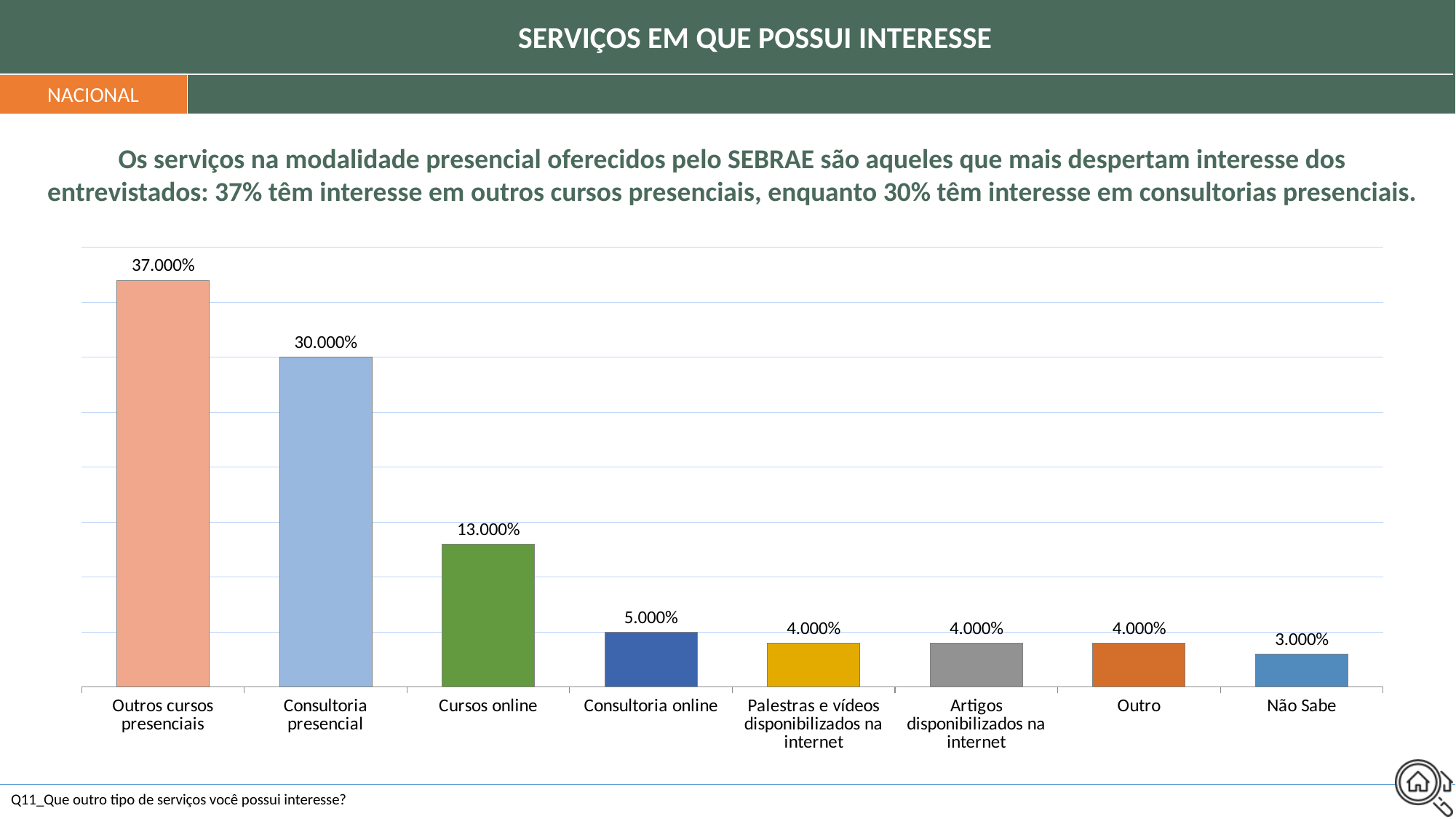
What is the value for Outros cursos presenciais? 37.000% What is the value for Cursos online? 13.000% What is the title of the slide? SERVIÇOS EM QUE POSSUI INTERESSE Which category has the lowest value? Não Sabe What is the value for Não Sabe? 3.000% Which is larger, Cursos online or Consultoria online? Cursos online Which category has the highest value? Outros cursos presenciais What is the difference between Outros cursos presenciais and Consultoria presencial? 7.000% How many categories are shown on the x axis? 8 What is the value for Consultoria presencial? 30.000% What is the value for Consultoria online? 5.000% What kind of chart is shown on the slide? Bar chart